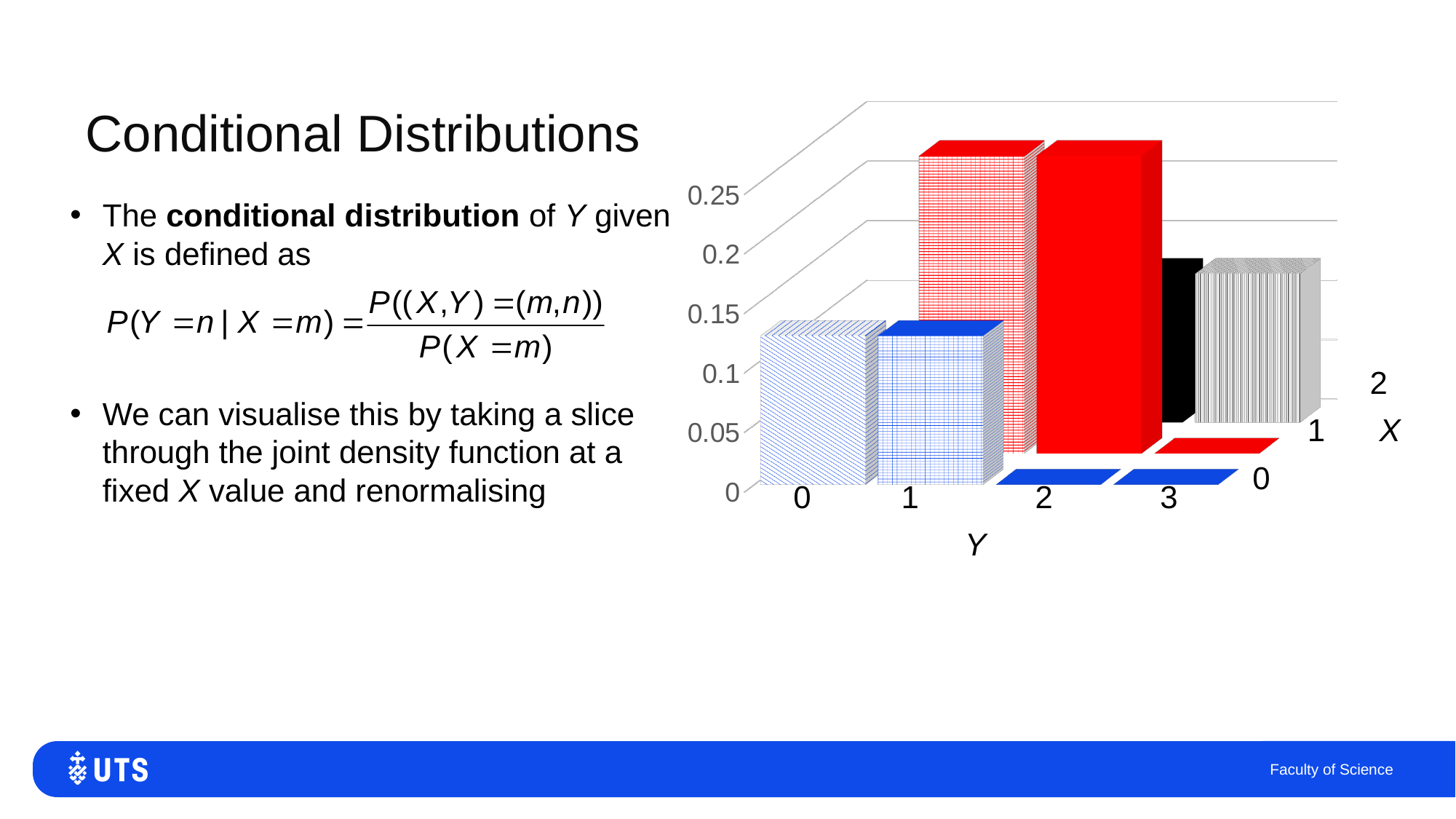
Is the value for Y = 0 at X = 0 greater or less than 0.1? greater What is the label of the horizontal (front) axis of the chart? Y Is the value for Y = 2 at X = 0 greater or less than 0.05? less How many Y categories are shown along the front axis of the chart? 4 Is the value for Y = 2 at X = 1 greater or less than 0.2? greater How many X values are shown along the depth axis of the chart? 3 What is the label of the depth axis of the chart? X What kind of chart is shown on the slide? bar chart Which X value contains the tallest bars in the chart? 1 Which is larger: the value for Y = 2 at X = 1 or the value for Y = 1 at X = 0? Y = 2 at X = 1